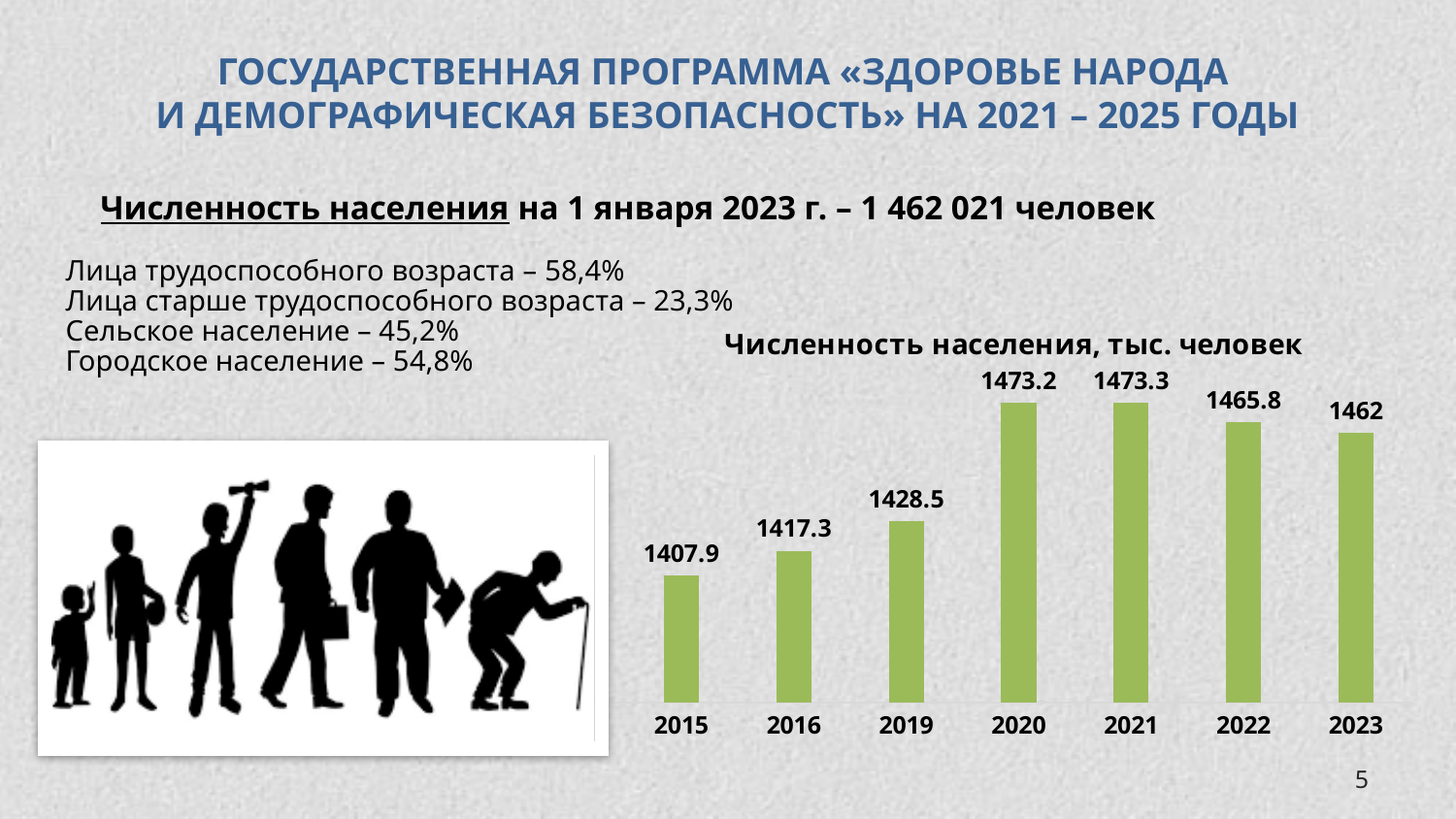
How many years are shown on the x axis of the chart? 7 What is the population value shown for 2019 in the chart? 1428.5 What is the difference between the population values for 2023 and 2015? 54.1 Which year has the lowest population value in the chart? 2015 What is the population value shown for 2020 in the chart? 1473.2 Does the population value rise or fall from 2021 to 2023? Fall What is the population value shown for 2023 in the chart? 1462 What kind of chart is used to show the population figures? Bar chart What is the title of the chart? Численность населения, тыс. человек Which year has the larger population value, 2016 or 2022? 2022 What is the population value shown for 2015 in the chart? 1407.9 What is the difference between the population values for 2020 and 2019? 44.7